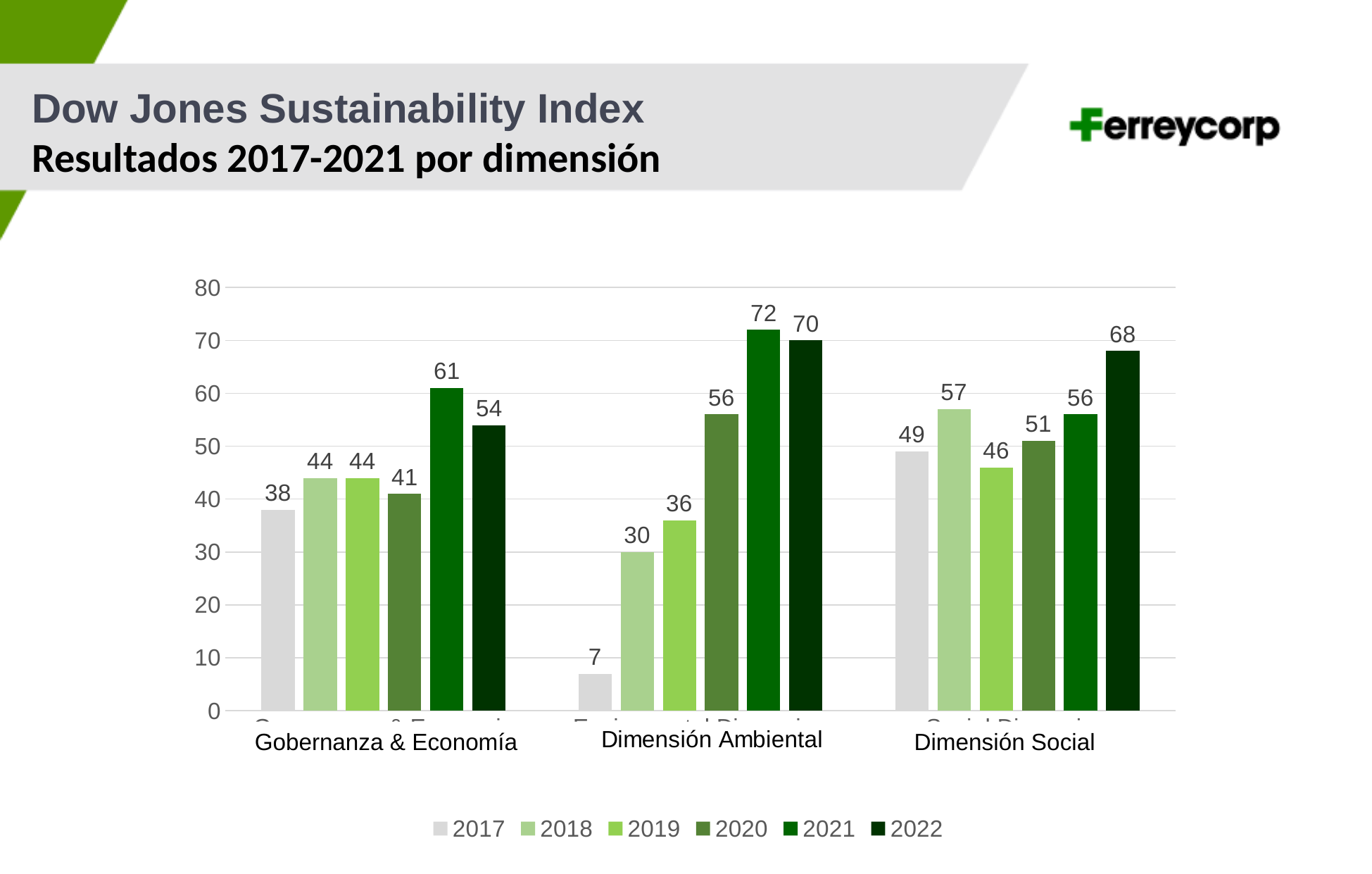
Which is larger in Dimensión Social: the 2018 value or the 2019 value? 2018 How many categories are shown on the x axis? 3 Is the value for 2022 in Gobernanza & Economía greater or less than 50? greater Which year has the lowest value in Dimensión Ambiental? 2017 Which year is shown in the lightest grey colour in the legend? 2017 Which year has the highest value in Gobernanza & Economía? 2021 What is the value for 2021 in Dimensión Ambiental? 72 What is the difference between the 2021 and 2017 values in Dimensión Ambiental? 65 What kind of chart is shown on the slide? Bar chart What is the value for 2017 in Gobernanza & Economía? 38 How many series does the legend list? 6 What is the value for 2022 in Dimensión Social? 68